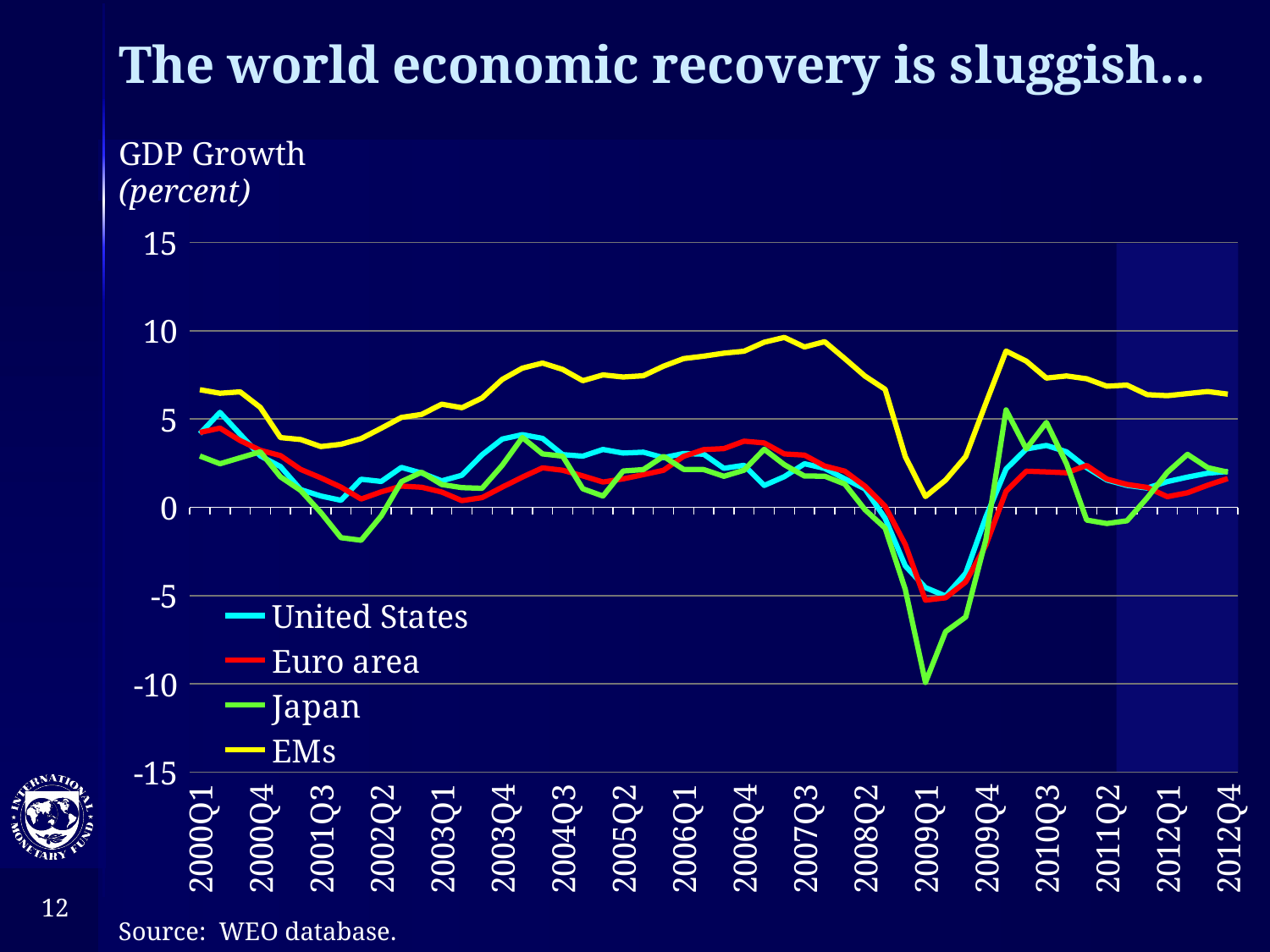
How many labels are shown on the x axis? 18 Is the value for EMs at 2012Q4 greater or less than 5? greater Is the value for Japan at 2009Q1 greater or less than -5? less Is the value for the United States at 2009Q1 greater or less than 0? less What colour is the line for Japan? Green How many series does the legend list? 4 Does the EMs line rise or fall between 2007Q3 and 2009Q1? Fall At 2009Q1, which is larger: the value for EMs or the value for the Euro area? EMs What kind of chart is shown on the slide? Line chart Which series has the lowest GDP growth value at 2009Q1? Japan Which series has the highest GDP growth value at 2009Q1? EMs